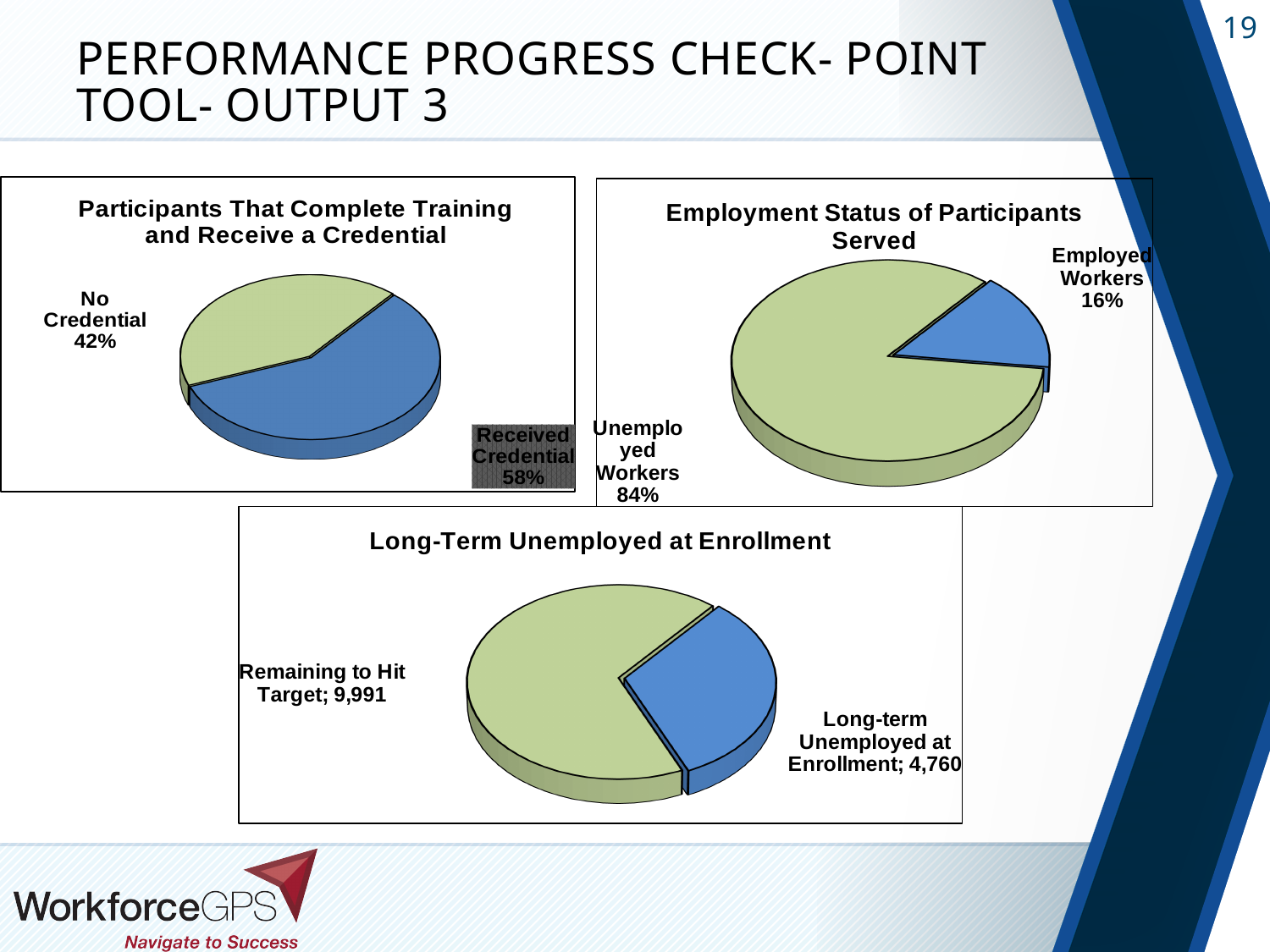
In the 'Long-Term Unemployed at Enrollment' chart, which slice is larger: Remaining to Hit Target or Long-term Unemployed at Enrollment? Remaining to Hit Target In the 'Employment Status of Participants Served' chart, which category is the largest? Unemployed Workers In the 'Participants That Complete Training and Receive a Credential' chart, what percentage had no credential? 42% In the 'Employment Status of Participants Served' chart, what share are Unemployed Workers? 84% How many slices does the 'Employment Status of Participants Served' pie chart have? 2 In the 'Participants That Complete Training and Receive a Credential' chart, which category is the smallest? No Credential In the 'Participants That Complete Training and Receive a Credential' chart, what percentage received a credential? 58% In the 'Long-Term Unemployed at Enrollment' chart, what is the value for Long-term Unemployed at Enrollment? 4,760 In the 'Long-Term Unemployed at Enrollment' chart, what is the difference between Remaining to Hit Target and Long-term Unemployed at Enrollment? 5,231 What type of chart is the 'Long-Term Unemployed at Enrollment' chart? Pie chart In the 'Long-Term Unemployed at Enrollment' chart, what is the value for Remaining to Hit Target? 9,991 In the 'Employment Status of Participants Served' chart, what share are Employed Workers? 16%